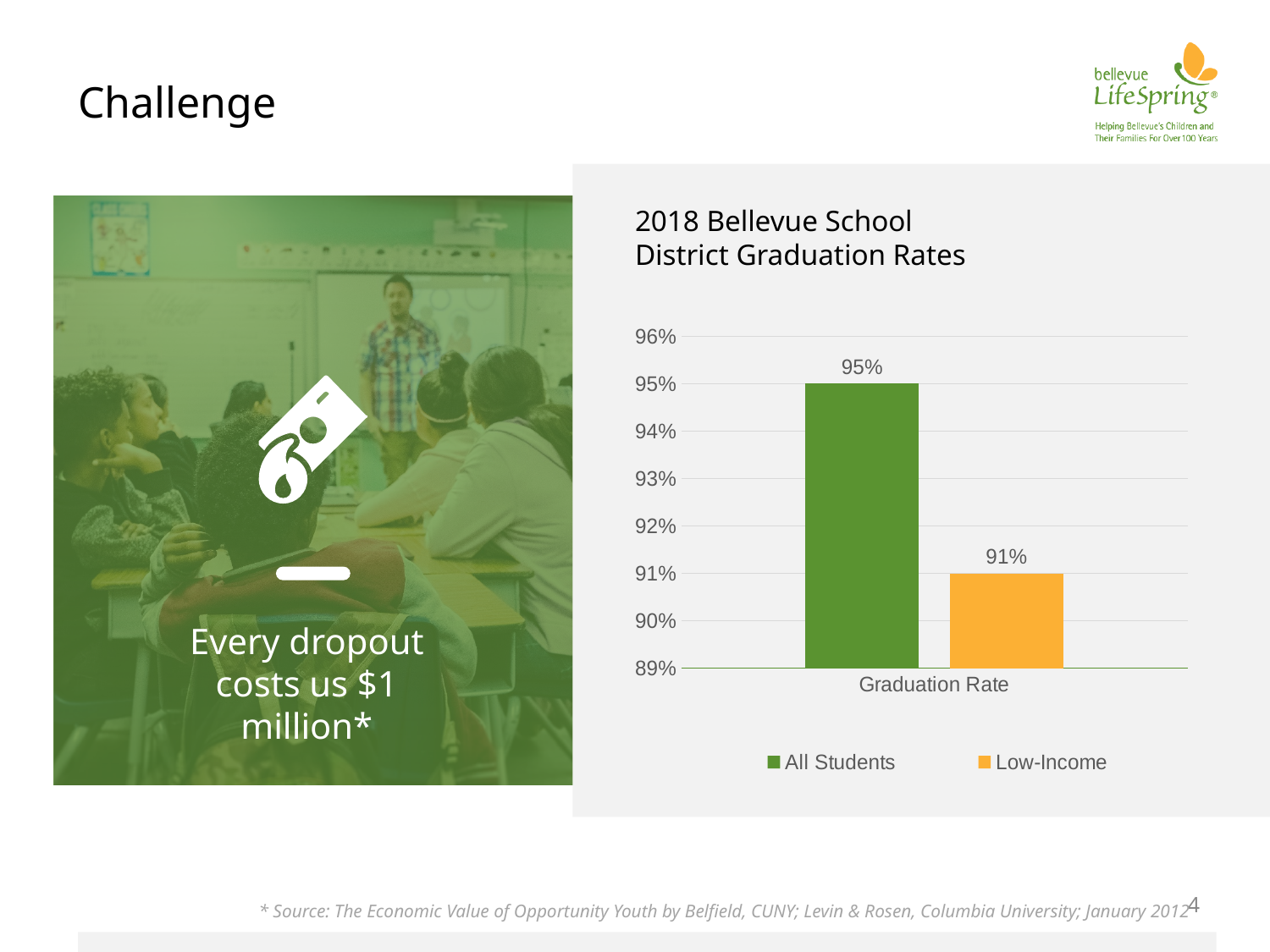
What is the title of the chart? 2018 Bellevue School District Graduation Rates How many series does the legend list? 2 What is the difference in percentage points between the All Students and Low-Income graduation rates? 4 percentage points Which series has the lowest graduation rate? Low-Income What is the graduation rate for All Students? 95% What is the category label on the x axis of the chart? Graduation Rate What kind of chart is shown on the slide? Bar chart What is the graduation rate for Low-Income students? 91% Which series has the higher graduation rate, All Students or Low-Income? All Students Is the Low-Income graduation rate greater or less than 92%? less What colour is the bar for Low-Income students? Orange Is the All Students graduation rate greater or less than 94%? greater